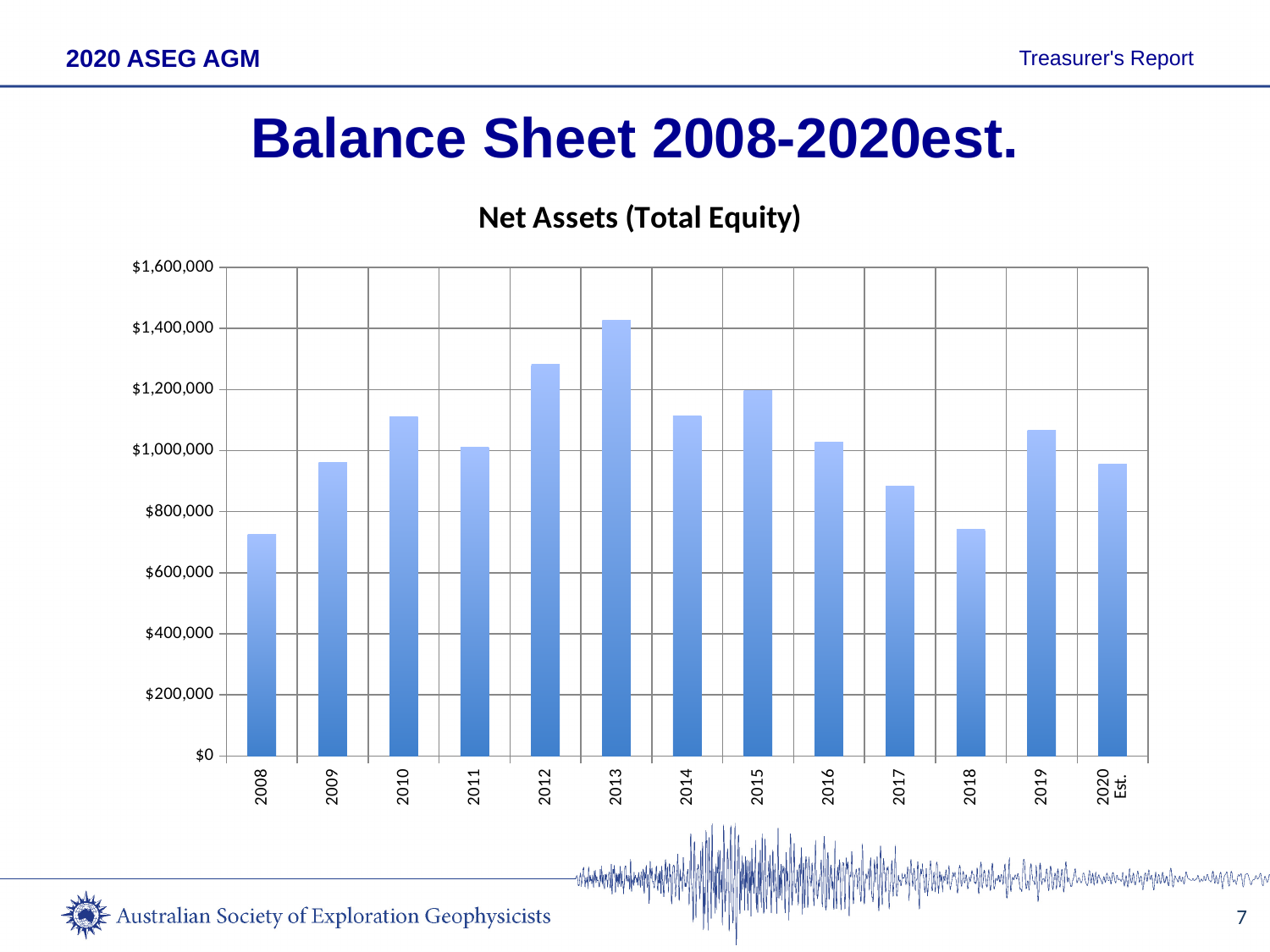
Do net assets rise or fall from 2008 to 2013? Rise Is the value for 2013 greater or less than $1,400,000? greater Which year has the highest net assets? 2013 Is the value for 2018 greater or less than $800,000? less Is the value for 2017 greater or less than $1,000,000? less Do net assets rise or fall from 2013 to 2018? Fall What type of chart is shown on the slide? Bar chart How many years (bars) are plotted in the chart? 13 What is the title of the chart? Net Assets (Total Equity) Which year has higher net assets, 2012 or 2015? 2012